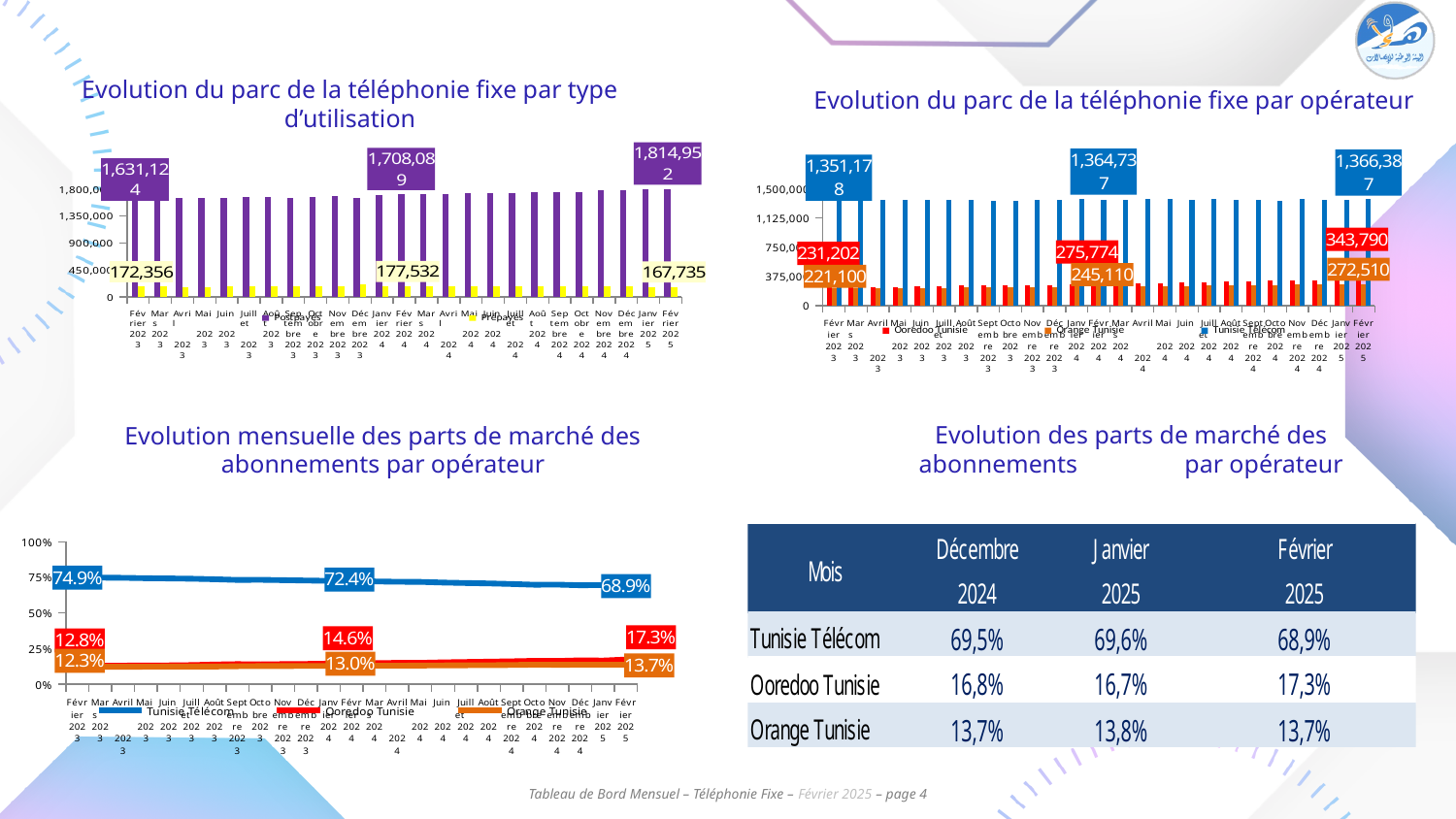
In the chart 'Evolution du parc de la téléphonie fixe par type d'utilisation', what is the Postpayés value for Février 2025? 1,814,952 How many series does the legend of 'Evolution du parc de la téléphonie fixe par opérateur' list? 3 In the chart 'Evolution mensuelle des parts de marché des abonnements par opérateur', what is the Tunisie Télécom share for Février 2025? 68.9% What kind of chart is 'Evolution mensuelle des parts de marché des abonnements par opérateur'? line chart In the chart 'Evolution du parc de la téléphonie fixe par type d'utilisation', what is the difference between the Postpayés values for Février 2025 and Février 2023? 183,828 How many series does the legend of 'Evolution du parc de la téléphonie fixe par type d'utilisation' list? 2 In the chart 'Evolution du parc de la téléphonie fixe par opérateur', what is the Ooredoo Tunisie value for Février 2025? 343,790 In the chart 'Evolution mensuelle des parts de marché des abonnements par opérateur', does the Tunisie Télécom share rise or fall from Février 2023 to Février 2025? fall What kind of chart is 'Evolution du parc de la téléphonie fixe par type d'utilisation'? bar chart In the chart 'Evolution du parc de la téléphonie fixe par opérateur', which is larger for Février 2025: Ooredoo Tunisie or Orange Tunisie? Ooredoo Tunisie